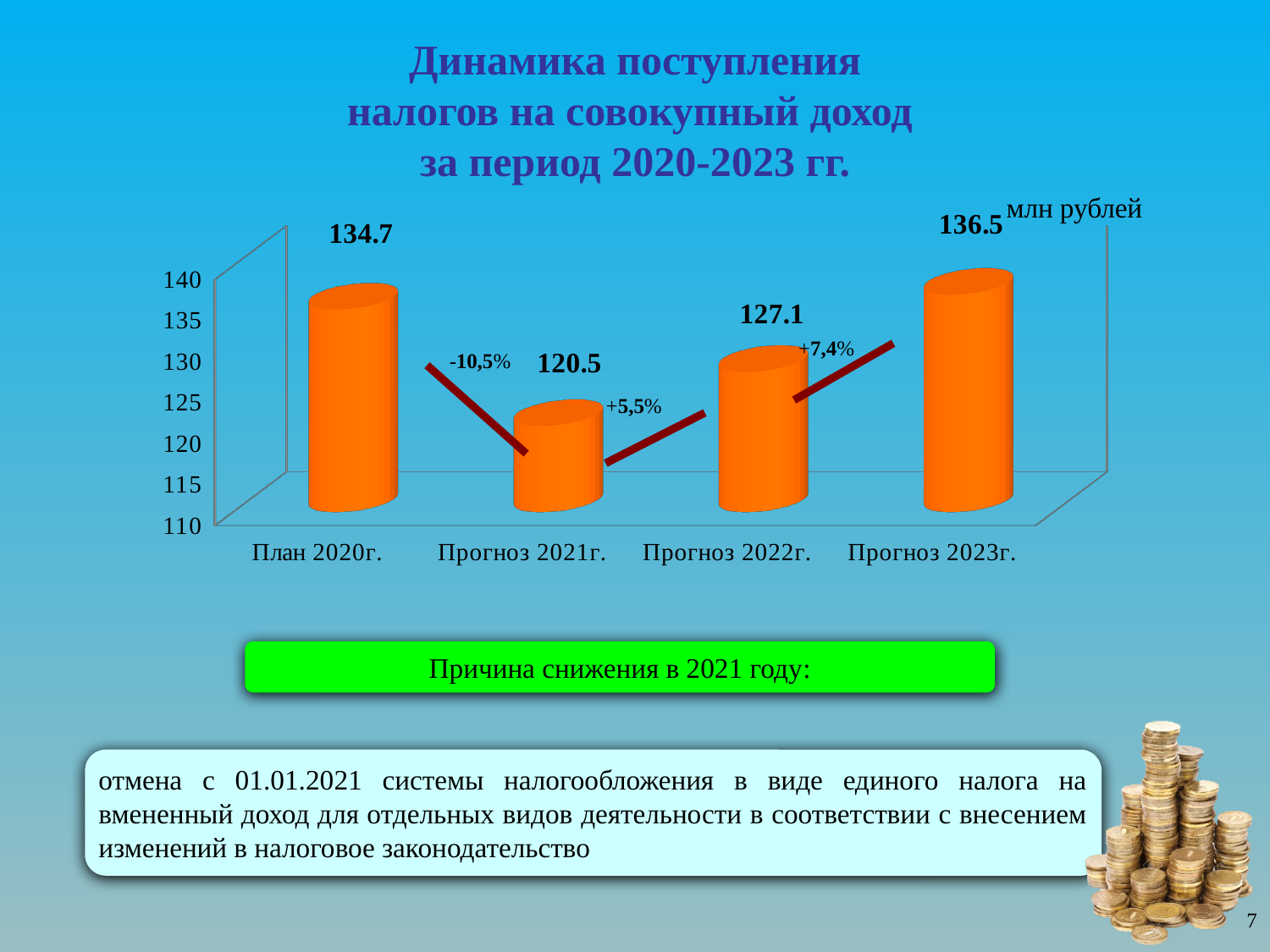
What kind of chart is shown on the slide? Bar chart Which category has the lowest value? Прогноз 2021г. What is the value for Прогноз 2023г.? 136.5 What is the difference between the values for План 2020г. and Прогноз 2021г.? 14.2 What is the value for План 2020г.? 134.7 What percentage change is annotated between Прогноз 2021г. and Прогноз 2022г.? +5,5% How many categories are shown on the chart? 4 What is the value for Прогноз 2022г.? 127.1 What is the value for Прогноз 2021г.? 120.5 Which category has the highest value? Прогноз 2023г. What unit is indicated for the values on the chart? млн рублей Which is larger, the value for Прогноз 2022г. or the value for План 2020г.? План 2020г.